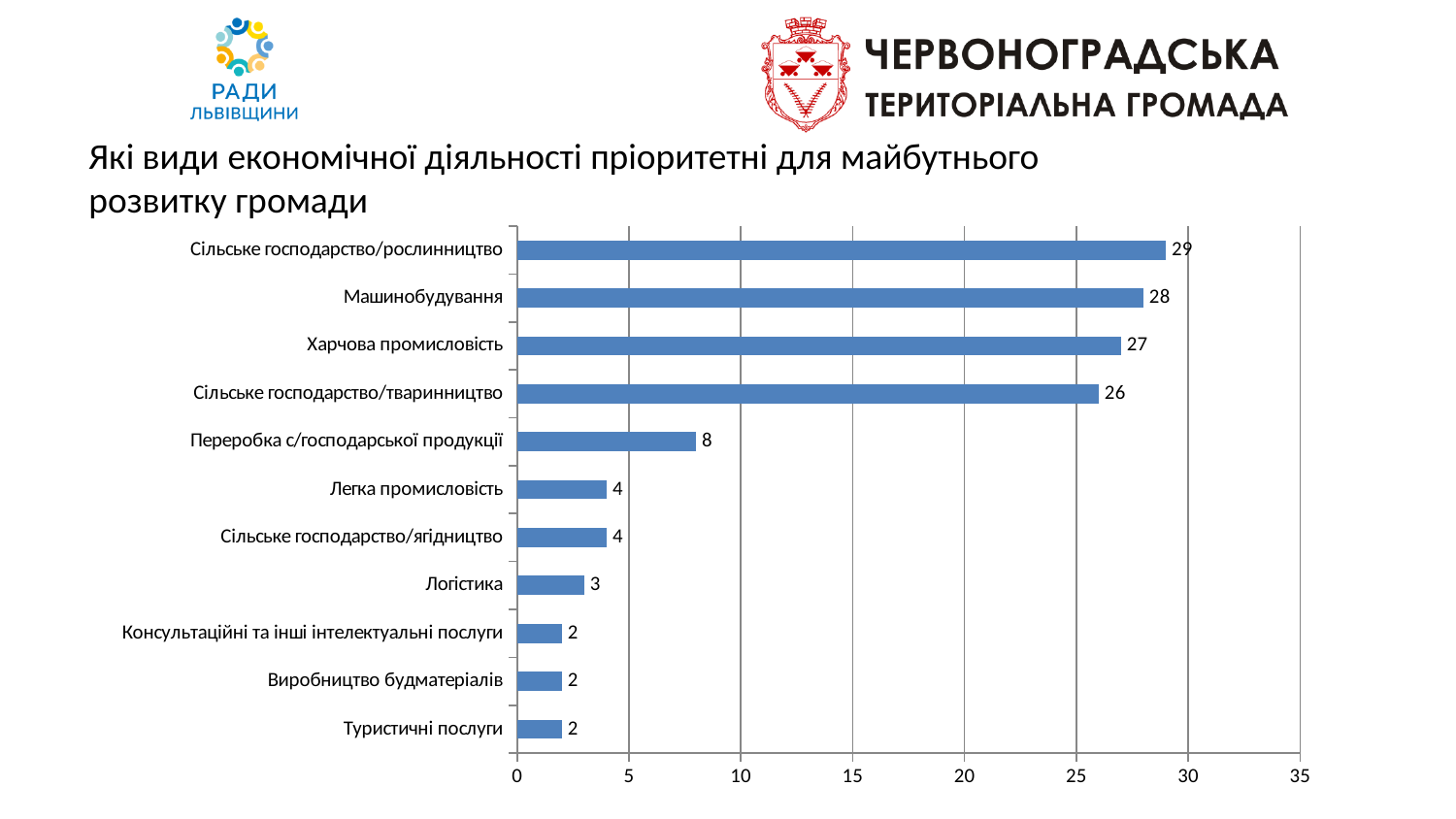
What is the value for Логістика? 3 What kind of chart is shown on the slide? bar chart What is the difference between the values for Сільське господарство/рослинництво and Сільське господарство/тваринництво? 3 Which is larger: the value for Харчова промисловість or the value for Легка промисловість? Харчова промисловість Which category has the highest value? Сільське господарство/рослинництво What is the difference between the values for Машинобудування and Переробка с/господарської продукції? 20 What is the value for Туристичні послуги? 2 What is the value for Машинобудування? 28 What is the value for Переробка с/господарської продукції? 8 What is the highest value shown on the horizontal axis? 35 Is the value for Сільське господарство/тваринництво greater or less than 25? greater How many categories are shown in the chart? 11